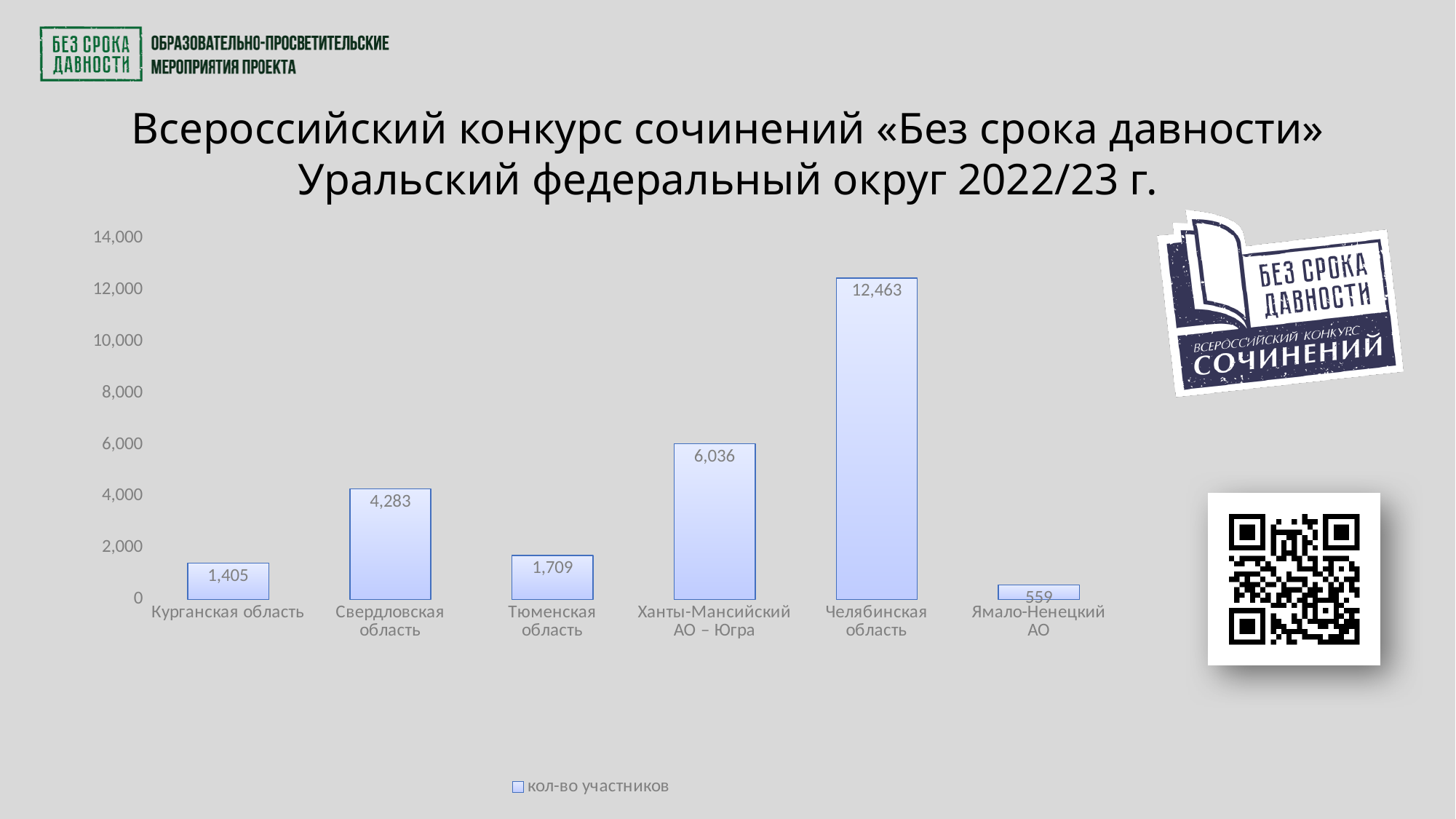
What kind of chart is shown on the slide? bar chart Is the value for Челябинская область greater or less than 12,000? greater What is the legend entry of the chart? кол-во участников How many regions are shown on the chart? 6 What is the value for Свердловская область? 4,283 How many series does the legend list? 1 What is the difference between the values for Челябинская область and Ханты-Мансийский АО – Югра? 6,427 What is the value for Ямало-Ненецкий АО? 559 Which region has the highest number of participants? Челябинская область What is the value for Ханты-Мансийский АО – Югра? 6,036 Which is larger, the value for Курганская область or the value for Тюменская область? Тюменская область Which region has the lowest number of participants? Ямало-Ненецкий АО